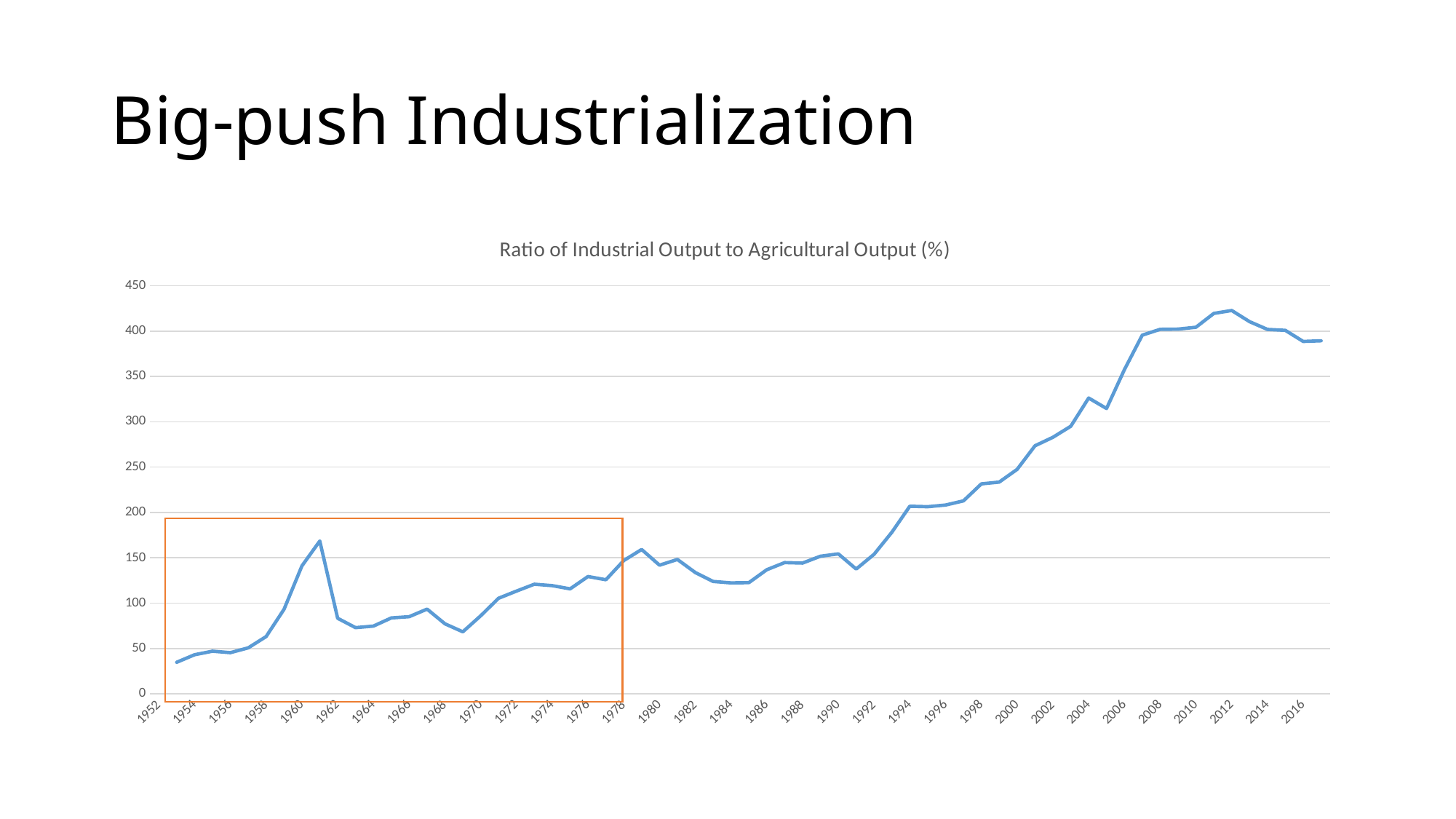
How many data series (lines) are plotted in the chart? 1 What is the title of the chart? Ratio of Industrial Output to Agricultural Output (%) Is the value for 2012 greater or less than 400? greater Which year has the higher value, 1961 or 1970? 1961 Which range of years is enclosed by the orange rectangle on the chart? 1952 to 1978 In which year does the line reach its highest point? 2012 Overall, does the ratio rise or fall from 1952 to 2016? Rises What type of chart is shown on the slide? Line chart Is the value for 1961 greater or less than 150? greater Does the line rise or fall between 2012 and 2016? Falls In which year does the line reach its lowest point? 1953